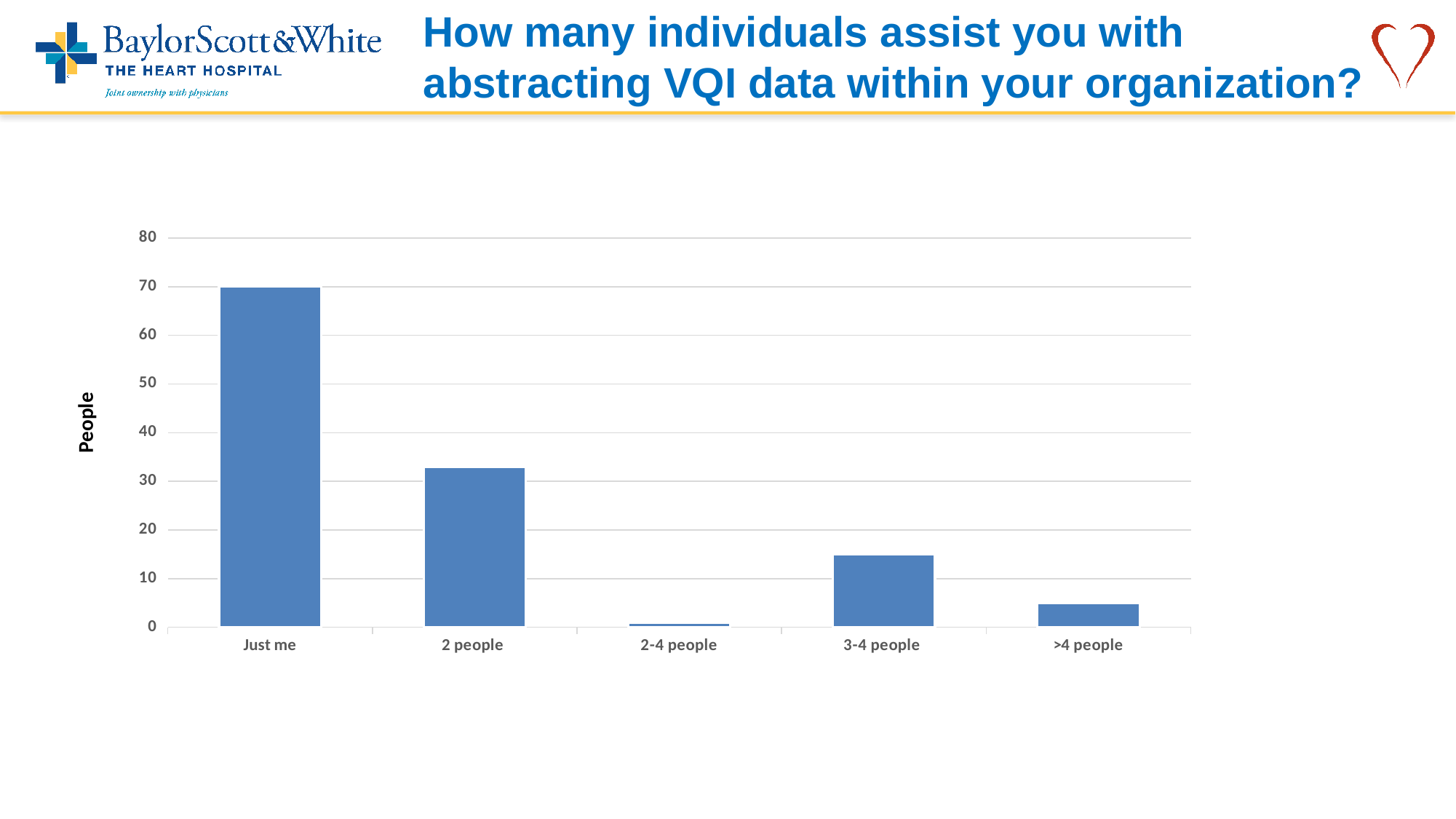
Is the value for 3-4 people greater or less than 10? greater Which category has the lowest value? 2-4 people Is the value for Just me greater or less than 60? greater Is the value for >4 people greater or less than 10? less How many categories are shown on the x axis of the chart? 5 Which is larger, the value for 3-4 people or the value for >4 people? 3-4 people Which category has the highest value? Just me What is the title of the slide containing the chart? How many individuals assist you with abstracting VQI data within your organization? What kind of chart is shown on the slide? bar chart What is the label on the y axis of the chart? People Which is larger, the value for 2 people or the value for 3-4 people? 2 people